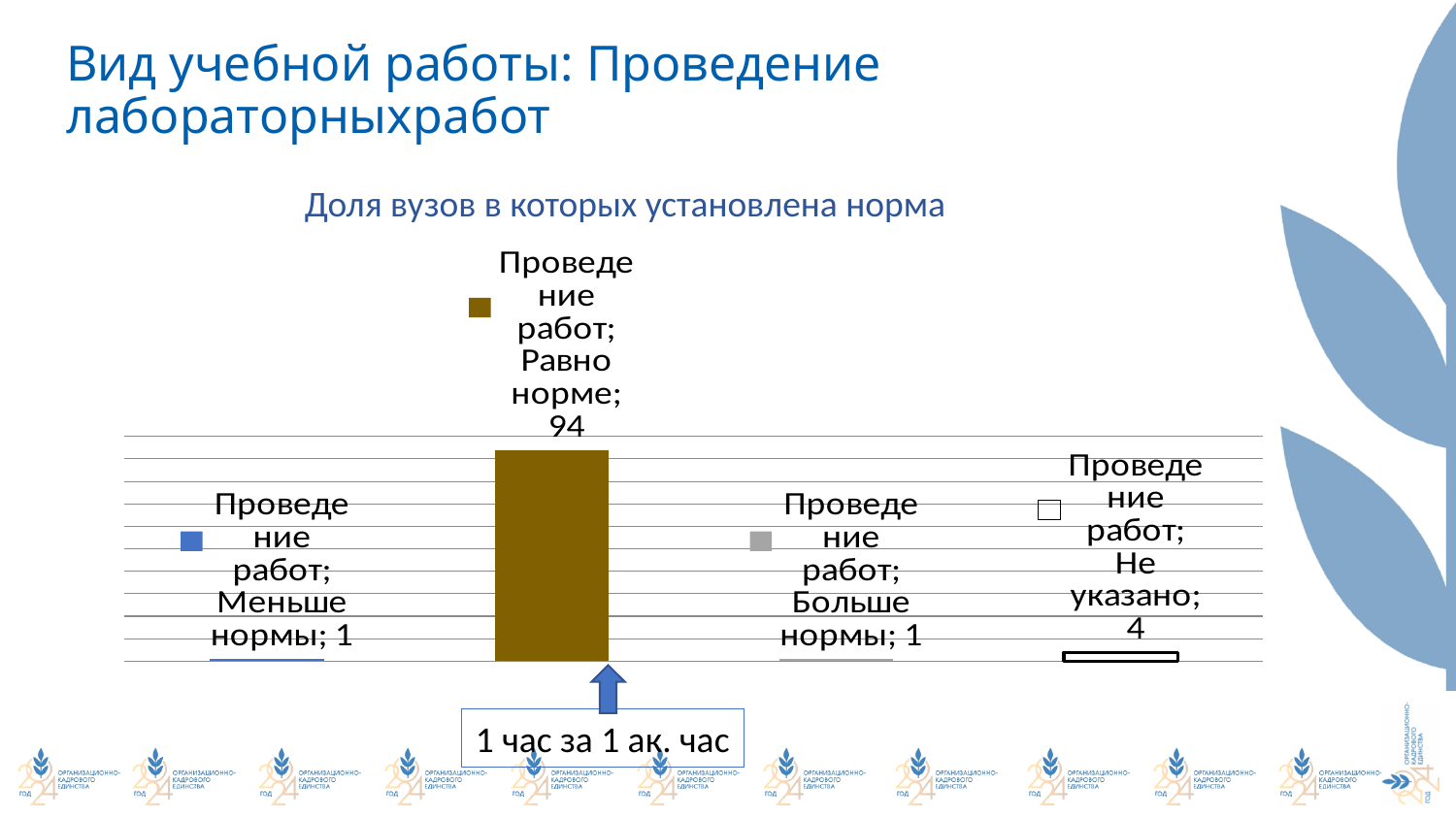
Which category has the highest value? Равно норме What value is shown for the category "Больше нормы"? 1 What text is in the callout box below the tallest bar? 1 час за 1 ак. час What is the total of all four values shown in the chart? 100 What value is shown for the category "Меньше нормы"? 1 What is the difference between the values for "Равно норме" and "Не указано"? 90 What kind of chart is shown on the slide? Bar chart What is the title of the chart? Доля вузов в которых установлена норма What value is shown for the category "Не указано"? 4 What value is shown for the category "Равно норме"? 94 How many categories are shown in the chart? 4 Which is larger, the value for "Не указано" or the value for "Больше нормы"? Не указано